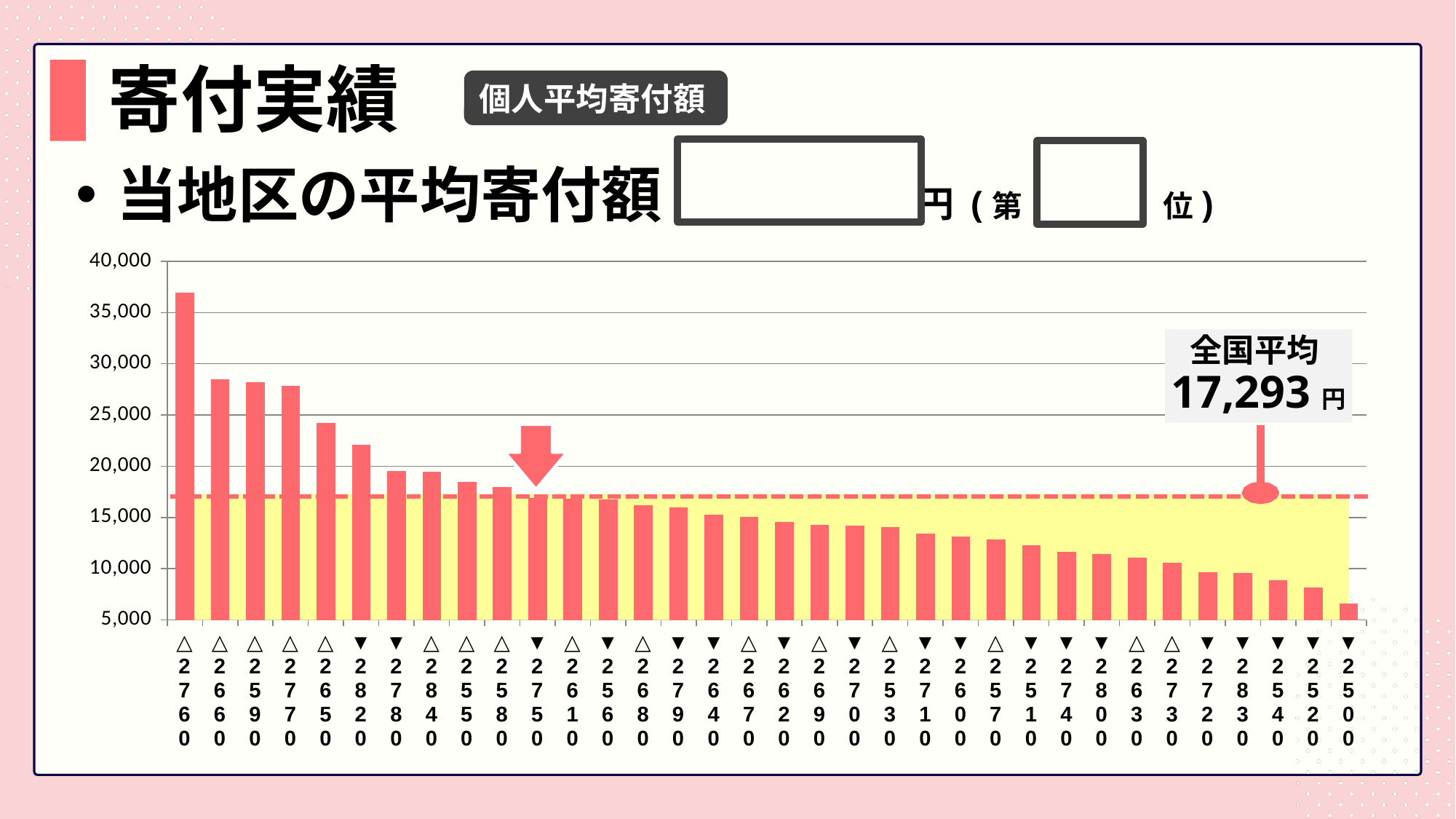
Is the value for △28400 greater or less than 20,000? less Is the value for ▼25000 greater or less than 10,000? less Which category has the highest bar in the chart? △27600 Is the value for △27600 greater or less than 35,000? greater Which is larger, the value for △27600 or the value for △26600? △27600 What kind of chart is shown on the slide? bar chart What is the highest value shown on the vertical axis of the chart? 40,000 Do the bar values rise or fall from left to right along the x axis? fall What is the national average (全国平均) value shown on the chart? 17,293 円 How many bars are plotted in the chart? 34 Which category has the lowest bar in the chart? ▼25000